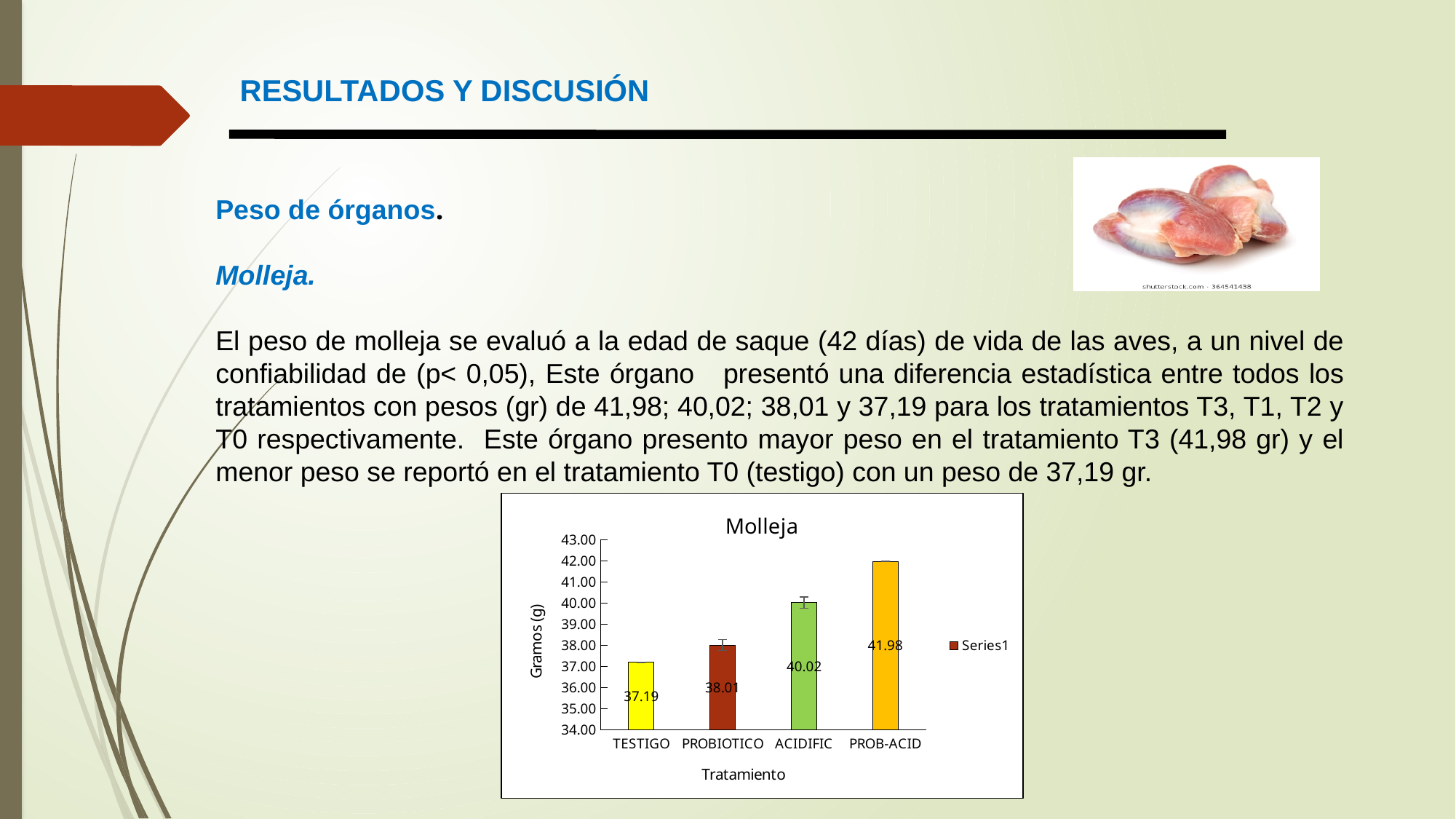
What is the difference between the PROB-ACID and TESTIGO values in the Molleja chart? 4.79 How many treatments are shown on the x axis of the Molleja chart? 4 Which treatment has the lowest value in the Molleja chart? TESTIGO What is the y-axis label of the Molleja chart? Gramos (g) What is the value for PROBIOTICO in the Molleja chart? 38.01 What is the value for TESTIGO in the Molleja chart? 37.19 Which is larger in the Molleja chart, ACIDIFIC or PROBIOTICO? ACIDIFIC What is the value for PROB-ACID in the Molleja chart? 41.98 Which treatment has the highest value in the Molleja chart? PROB-ACID Is the value for ACIDIFIC in the Molleja chart greater or less than 39.00? greater What kind of chart is the Molleja chart? bar chart What is the value for ACIDIFIC in the Molleja chart? 40.02